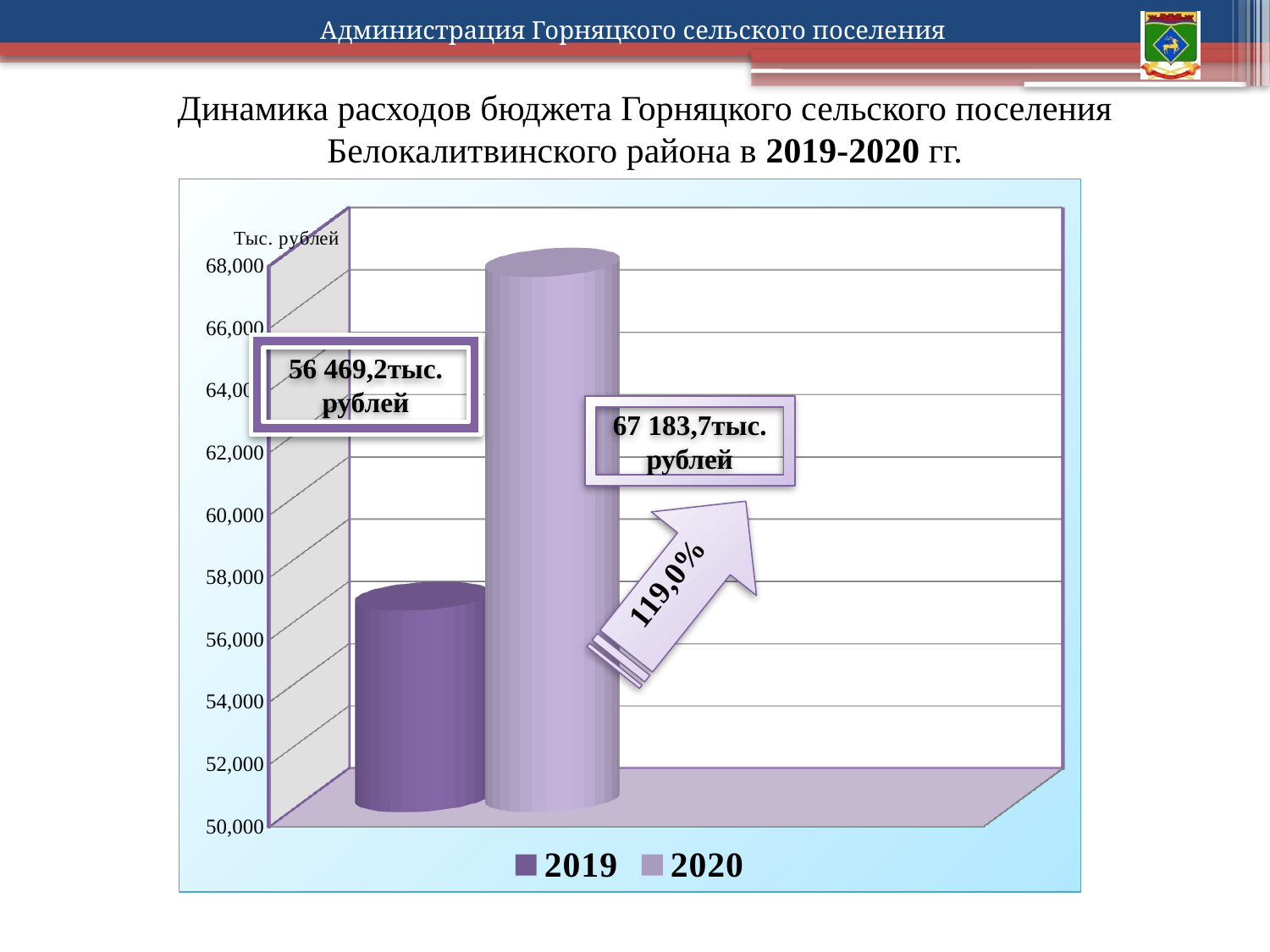
What is the difference between the 2020 and 2019 budget expenditure values? 10 714,5 тыс. рублей Do the budget expenditure values rise or fall from 2019 to 2020? rise What is the budget expenditure value shown for 2019? 56 469,2 тыс. рублей Is the value for 2019 greater or less than 58,000? less Which year shows the lowest budget expenditure? 2019 Which year has the higher budget expenditure, 2019 or 2020? 2020 Which year shows the highest budget expenditure? 2020 What type of chart is shown on the slide? bar chart What is the budget expenditure value shown for 2020? 67 183,7 тыс. рублей How many series does the legend list? 2 What percentage is shown on the arrow between the two bars? 119,0% How many bars are plotted on the chart? 2